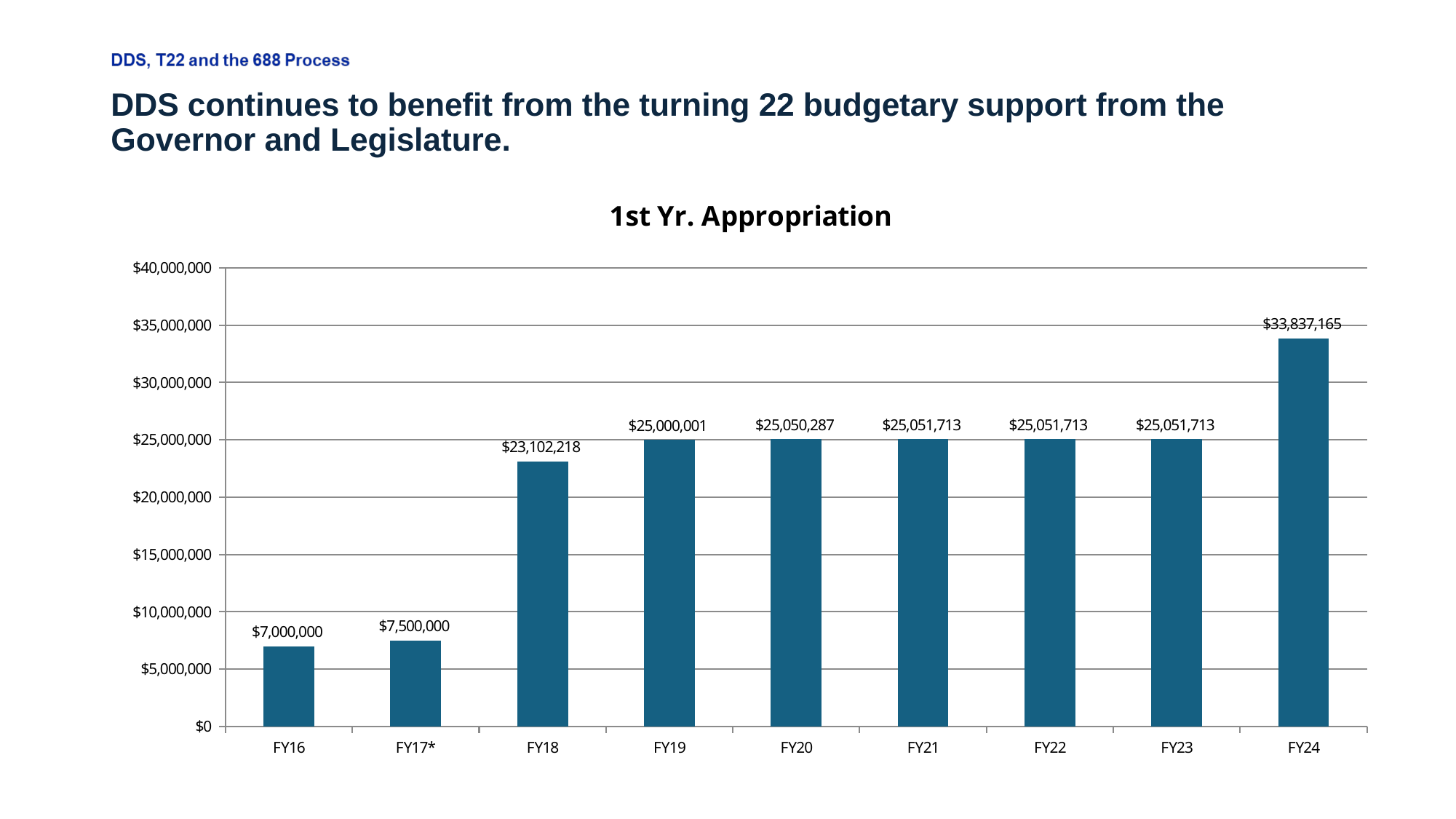
Which is larger, the appropriation for FY18 or for FY19? FY19 What is the title of the chart? 1st Yr. Appropriation Which fiscal year has the highest 1st Yr. Appropriation? FY24 What is the 1st Yr. Appropriation value for FY17*? $7,500,000 What is the difference between the FY24 and FY23 appropriation values? $8,785,452 What is the difference between the FY17* and FY16 appropriation values? $500,000 Is the value for FY20 greater or less than $20,000,000? greater Which fiscal year has the lowest 1st Yr. Appropriation? FY16 What is the 1st Yr. Appropriation value for FY18? $23,102,218 What is the 1st Yr. Appropriation value for FY24? $33,837,165 What kind of chart is shown on the slide? bar chart How many fiscal years are shown on the x axis of the chart? 9